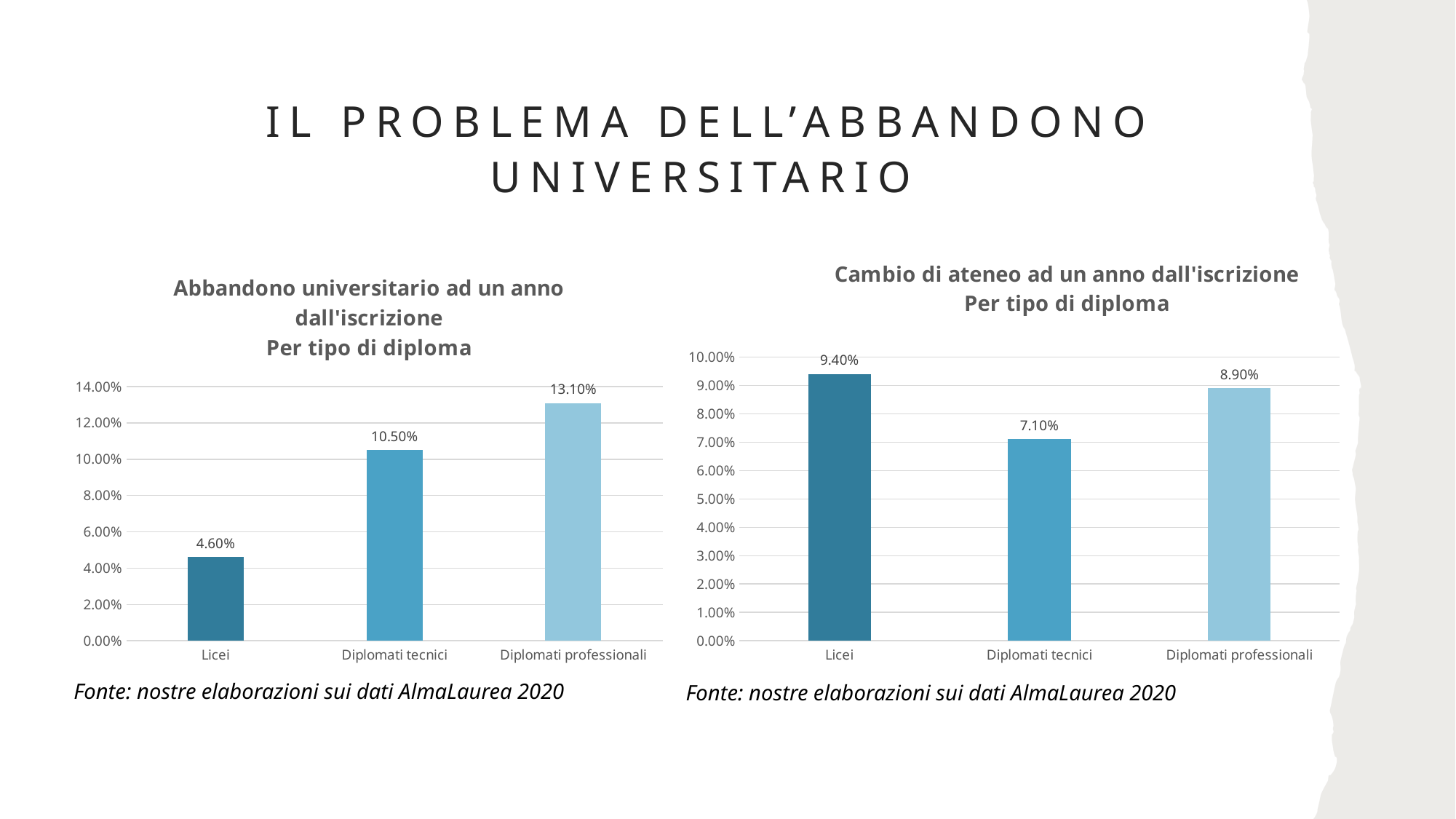
In the left chart (Abbandono universitario ad un anno dall'iscrizione), what is the difference between Diplomati professionali and Licei? 8.50% In the right chart (Cambio di ateneo ad un anno dall'iscrizione), what is the value for Diplomati tecnici? 7.10% In the right chart (Cambio di ateneo ad un anno dall'iscrizione), which category has the lowest value? Diplomati tecnici In the left chart (Abbandono universitario ad un anno dall'iscrizione), do the values rise or fall from Licei to Diplomati professionali? Rise How many categories are shown in the left chart (Abbandono universitario ad un anno dall'iscrizione)? 3 What kind of chart is the right chart (Cambio di ateneo ad un anno dall'iscrizione)? Bar chart In the left chart (Abbandono universitario ad un anno dall'iscrizione), what is the value for Licei? 4.60% In the left chart (Abbandono universitario ad un anno dall'iscrizione), which category has the highest value? Diplomati professionali In the right chart (Cambio di ateneo ad un anno dall'iscrizione), which is larger: Licei or Diplomati tecnici? Licei In the right chart (Cambio di ateneo ad un anno dall'iscrizione), what is the value for Licei? 9.40% In the left chart (Abbandono universitario ad un anno dall'iscrizione), what is the value for Diplomati professionali? 13.10% In the right chart (Cambio di ateneo ad un anno dall'iscrizione), what is the difference between Licei and Diplomati professionali? 0.50%